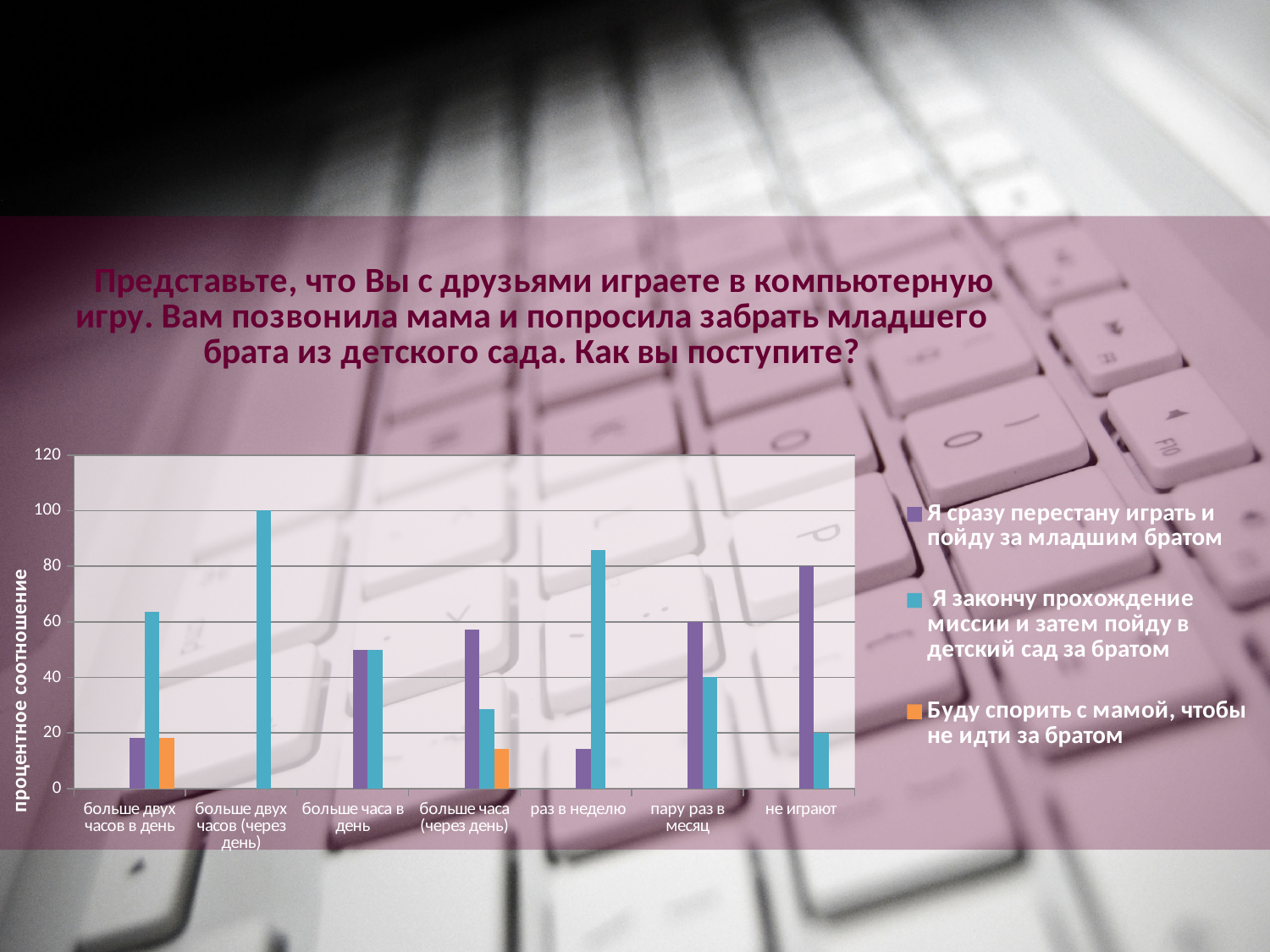
How many categories are shown along the x axis? 7 What kind of chart is shown on the slide? bar chart Which category has the highest value for the series 'Я закончу прохождение миссии и затем пойду в детский сад за братом'? больше двух часов (через день) For 'не играют', which series has the larger value: 'Я сразу перестану играть и пойду за младшим братом' or 'Я закончу прохождение миссии и затем пойду в детский сад за братом'? Я сразу перестану играть и пойду за младшим братом What is the label of the vertical axis? процентное соотношение Is the value for 'больше часа (через день)' in the series 'Буду спорить с мамой, чтобы не идти за братом' greater or less than 20? less What colour represents the series 'Буду спорить с мамой, чтобы не идти за братом' in the legend? orange For 'раз в неделю', which series has the larger value: 'Я сразу перестану играть и пойду за младшим братом' or 'Я закончу прохождение миссии и затем пойду в детский сад за братом'? Я закончу прохождение миссии и затем пойду в детский сад за братом Is the value for 'раз в неделю' in the series 'Я закончу прохождение миссии и затем пойду в детский сад за братом' greater or less than 80? greater Which category has the highest value for the series 'Я сразу перестану играть и пойду за младшим братом'? не играют How many series does the legend list? 3